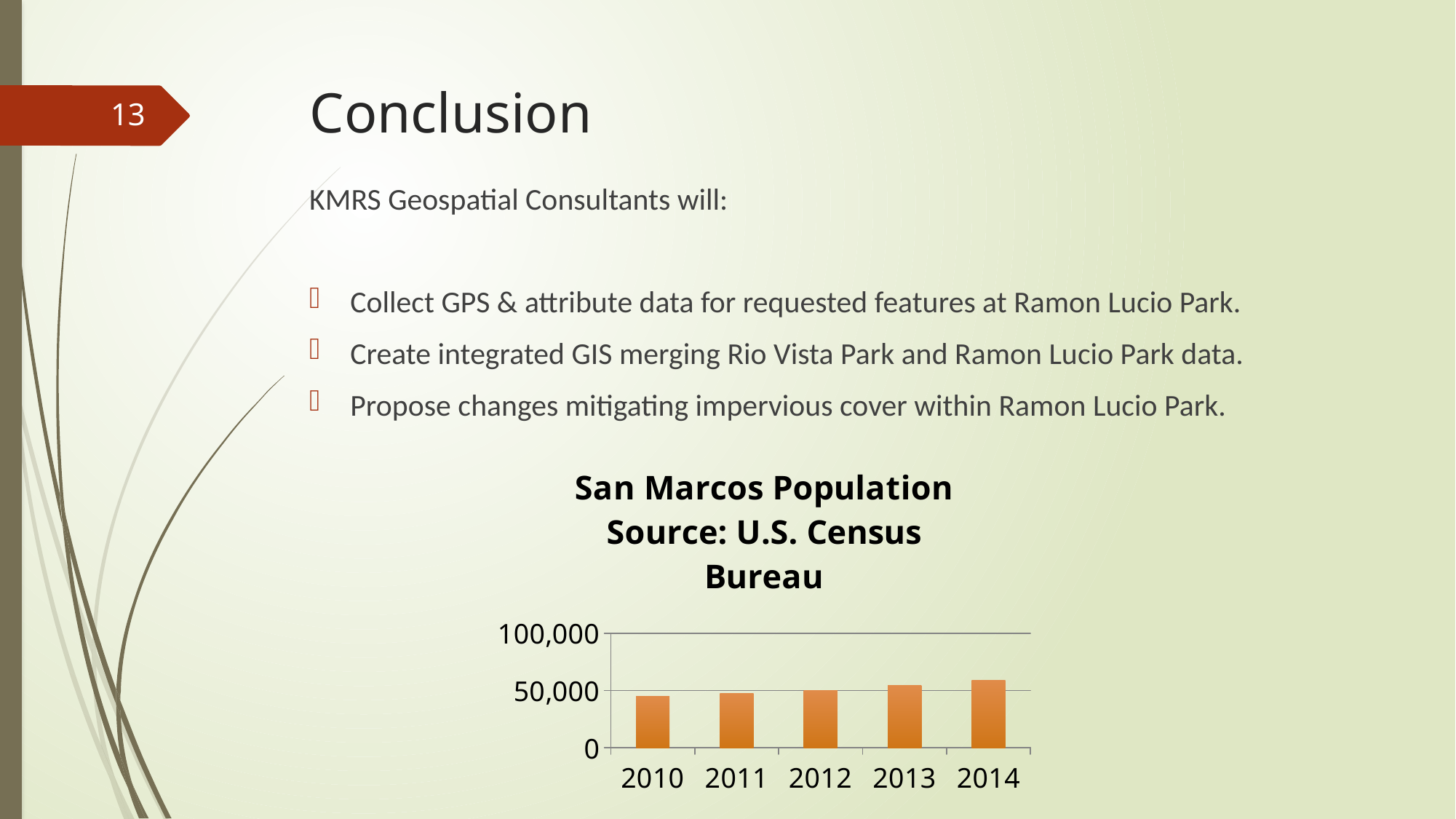
Which year has the larger population, 2010 or 2014? 2014 Is the value for 2014 greater or less than 100,000? less Is the value for 2010 greater or less than 50,000? less Is the value for 2013 greater or less than 50,000? greater Does the population rise or fall from 2010 to 2014 in the San Marcos Population chart? rise How many years are shown on the x axis of the San Marcos Population chart? 5 What is the highest value labelled on the y axis of the chart? 100,000 Which year has the lowest population in the San Marcos Population chart? 2010 What is the title of the chart on the slide? San Marcos Population Source: U.S. Census Bureau Which year has the highest population in the San Marcos Population chart? 2014 What kind of chart is shown on the slide? bar chart